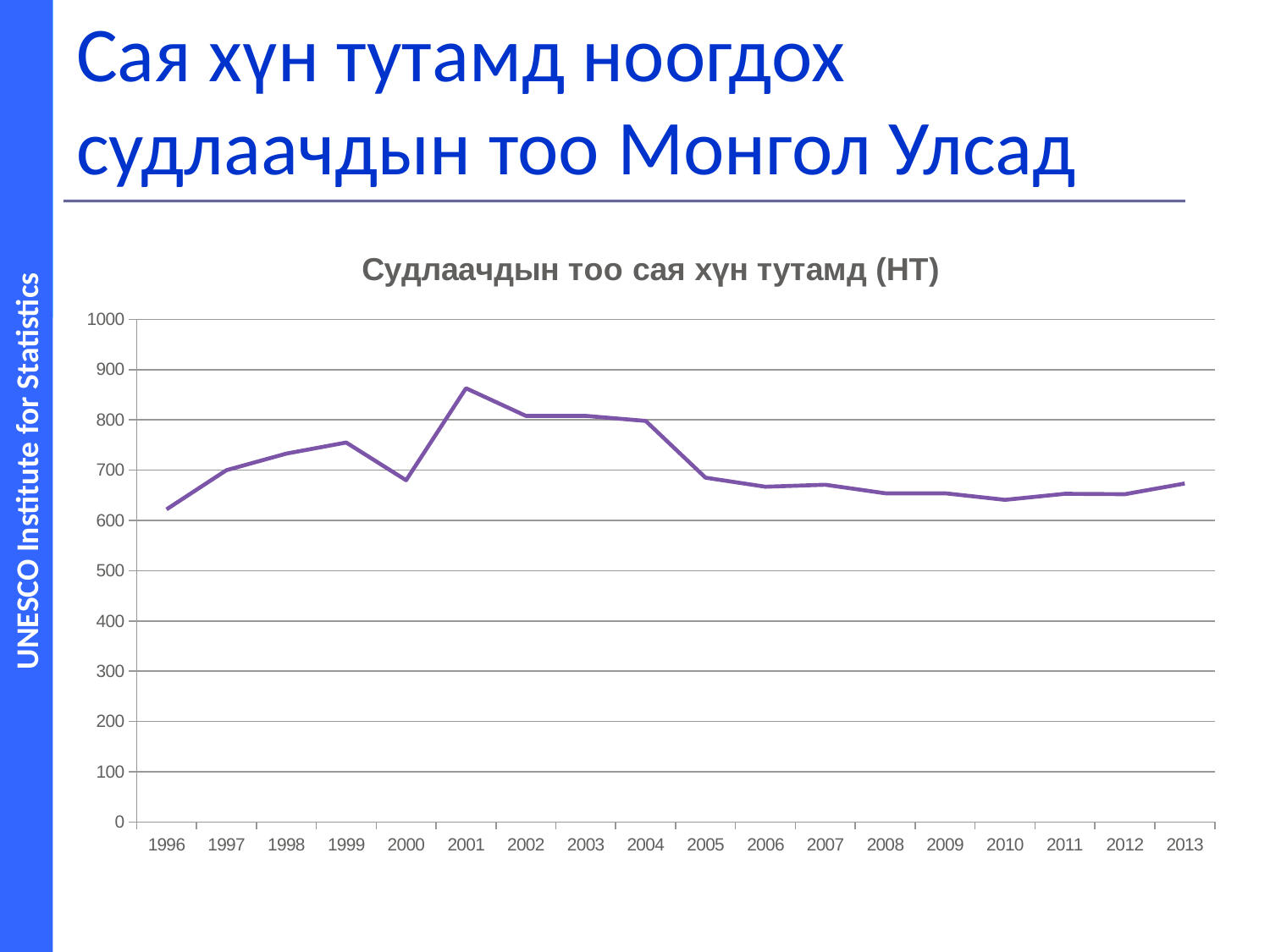
Which is larger, the value for 2001 or the value for 2005? 2001 How many years are plotted along the x axis of the chart? 18 Which is larger, the value for 1999 or the value for 2000? 1999 Do the values rise or fall from 1996 to 1999? rise What kind of chart is shown on the slide? line chart Is the value for 1996 greater or less than 600? greater Is the value for 2013 greater or less than 700? less Is the value for 2000 greater or less than 700? less What is the title of the chart? Судлаачдын тоо сая хүн тутамд (HT) Which year has the highest value in the chart? 2001